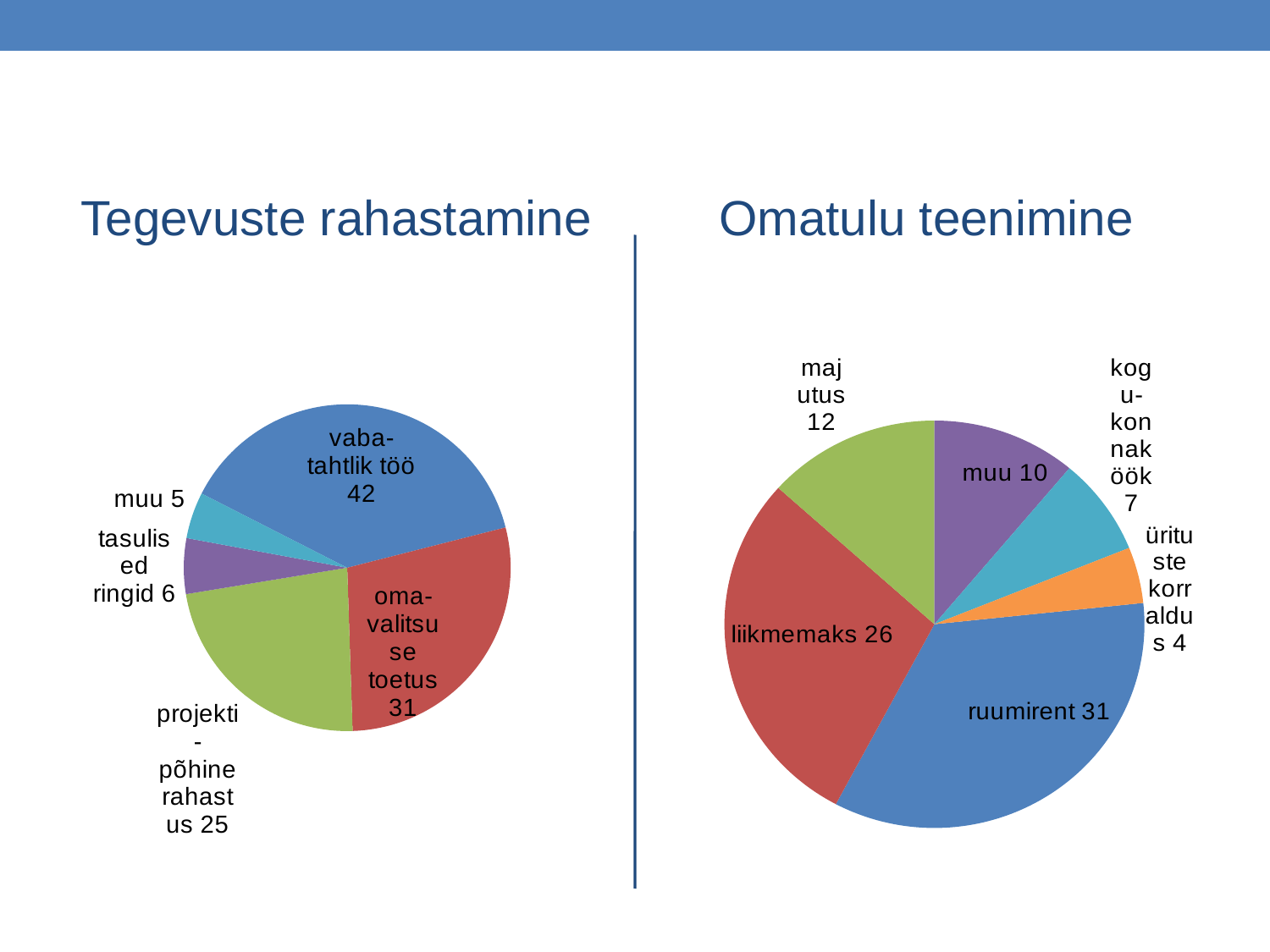
In the "Tegevuste rahastamine" chart, what is the value for omavalitsuse toetus? 31 What type of chart is used for "Tegevuste rahastamine"? Pie chart How many slices does the "Tegevuste rahastamine" pie chart have? 5 In the "Tegevuste rahastamine" chart, what is the value for vabatahtlik töö? 42 In the "Omatulu teenimine" chart, which is larger: majutus or muu? majutus In the "Tegevuste rahastamine" chart, which category has the largest slice? vabatahtlik töö In the "Tegevuste rahastamine" chart, what is the difference between vabatahtlik töö and projektipõhine rahastus? 17 In the "Tegevuste rahastamine" chart, which category has the smallest slice? muu In the "Omatulu teenimine" chart, what is the value for liikmemaks? 26 In the "Omatulu teenimine" chart, which category has the smallest slice? ürituste korraldus In the "Omatulu teenimine" chart, what is the value for ruumirent? 31 How many slices does the "Omatulu teenimine" pie chart have? 6